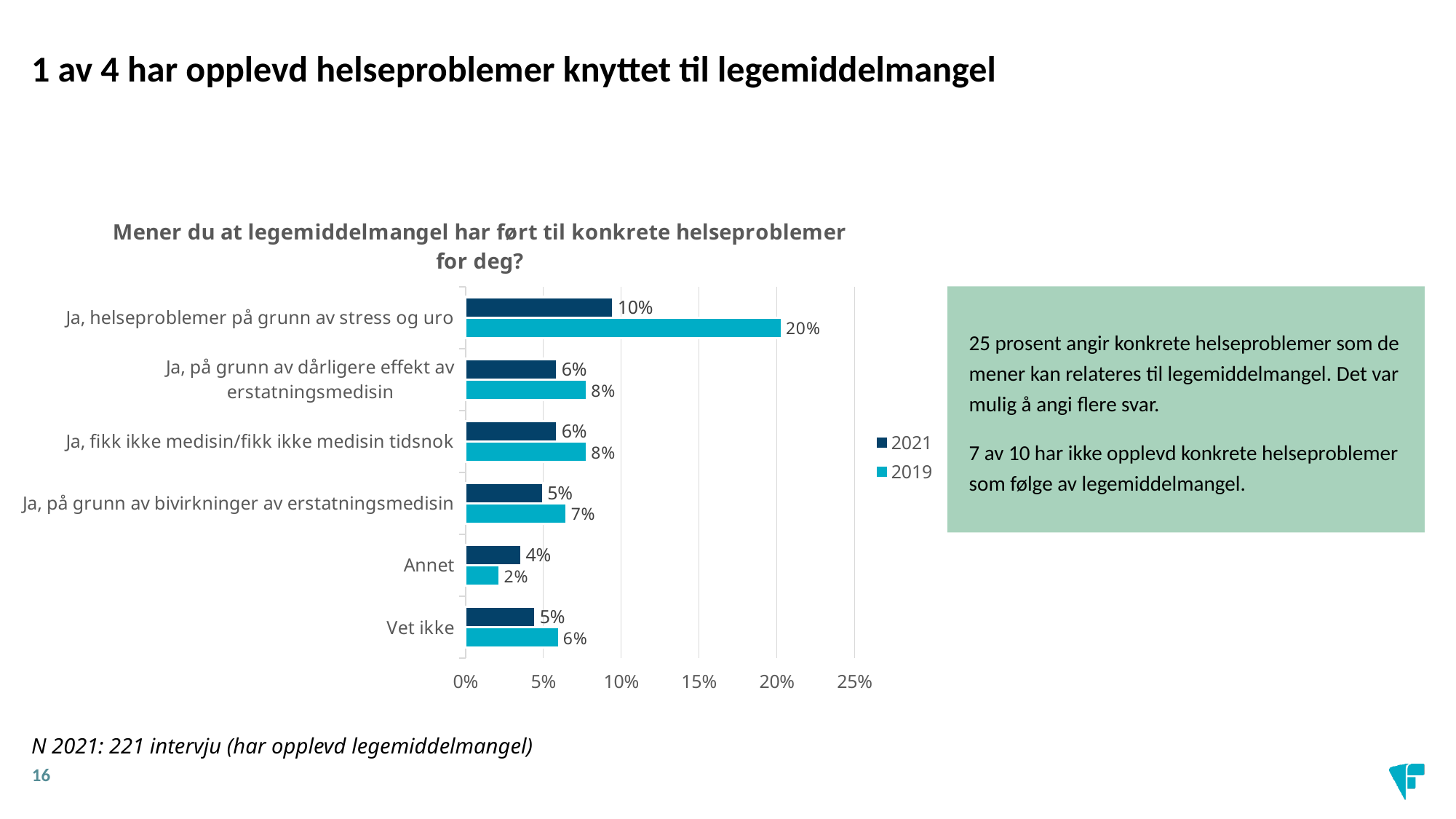
Is the 2019 value for "Ja, helseproblemer på grunn av stress og uro" greater or less than 15%? greater What kind of chart is shown on the slide? Bar chart Which category has the highest 2019 value? Ja, helseproblemer på grunn av stress og uro What is the 2019 value for "Ja, helseproblemer på grunn av stress og uro"? 20% Which category has the lowest 2019 value? Annet What is the 2019 value for "Vet ikke"? 6% How many series does the legend list? 2 What is the 2021 value for "Annet"? 4% What is the difference between the 2019 and 2021 values for "Ja, helseproblemer på grunn av stress og uro"? 10% What is the 2021 value for "Ja, helseproblemer på grunn av stress og uro"? 10% For "Annet", which year has the larger value, 2021 or 2019? 2021 How many categories are shown on the chart? 6